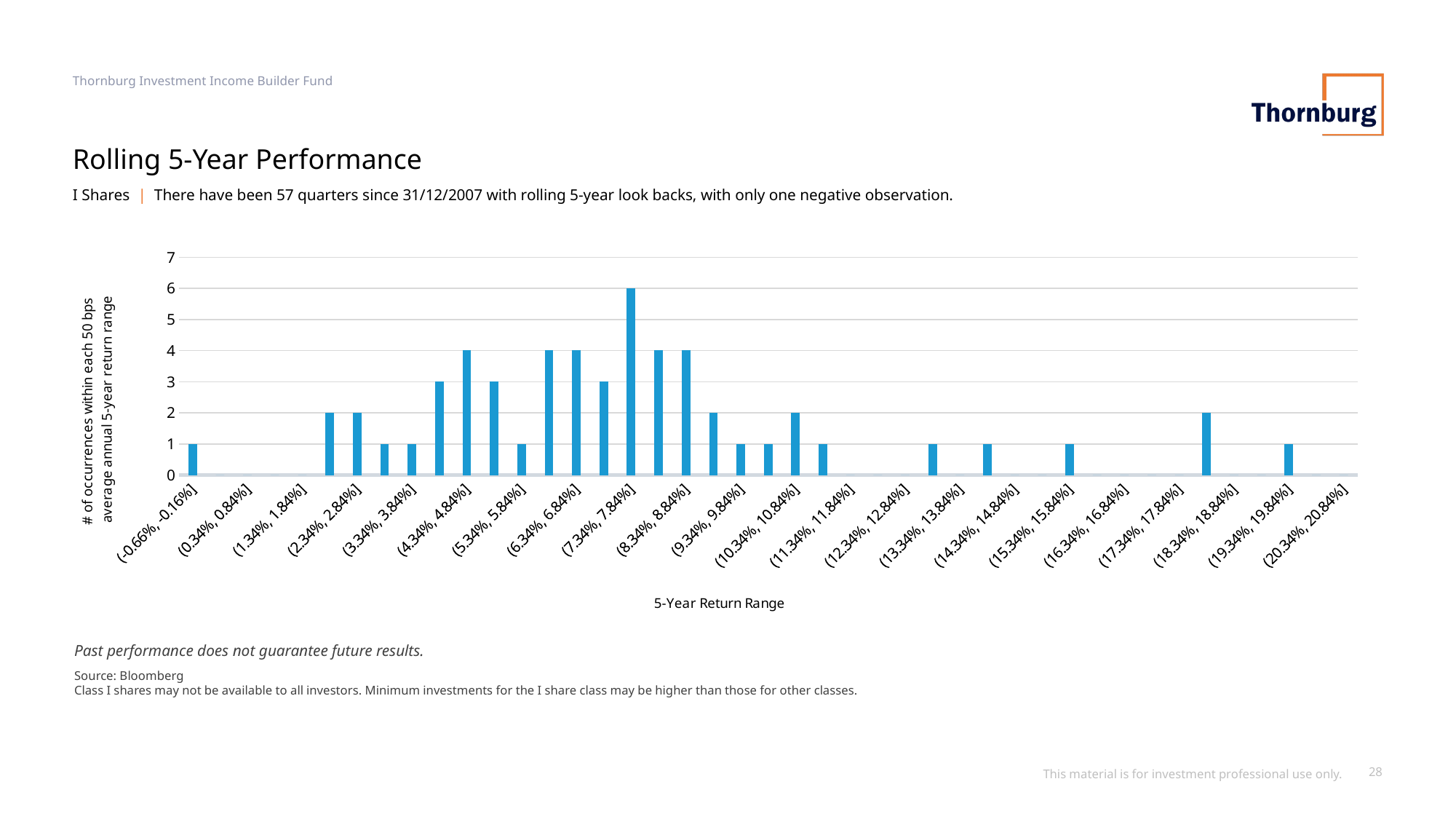
How many occurrences are shown for the (19.34%, 19.84%] return range? 1 What is the title of the x axis? 5-Year Return Range Is the number of occurrences for the (2.34%, 2.84%] range greater or less than 3? less Which has more occurrences, the (6.34%, 6.84%] range or the (5.34%, 5.84%] range? (6.34%, 6.84%] What is the difference in occurrences between the (7.34%, 7.84%] range and the (8.34%, 8.84%] range? 2 How many occurrences are shown for the (7.34%, 7.84%] return range? 6 What type of chart is shown on the slide? Bar chart Which labelled return range has the highest number of occurrences? (7.34%, 7.84%] What is the highest value shown on the y axis? 7 How many occurrences are shown for the (10.34%, 10.84%] return range? 2 How many occurrences are shown for the (4.34%, 4.84%] return range? 4 How many occurrences are shown for the (-0.66%, -0.16%] return range? 1